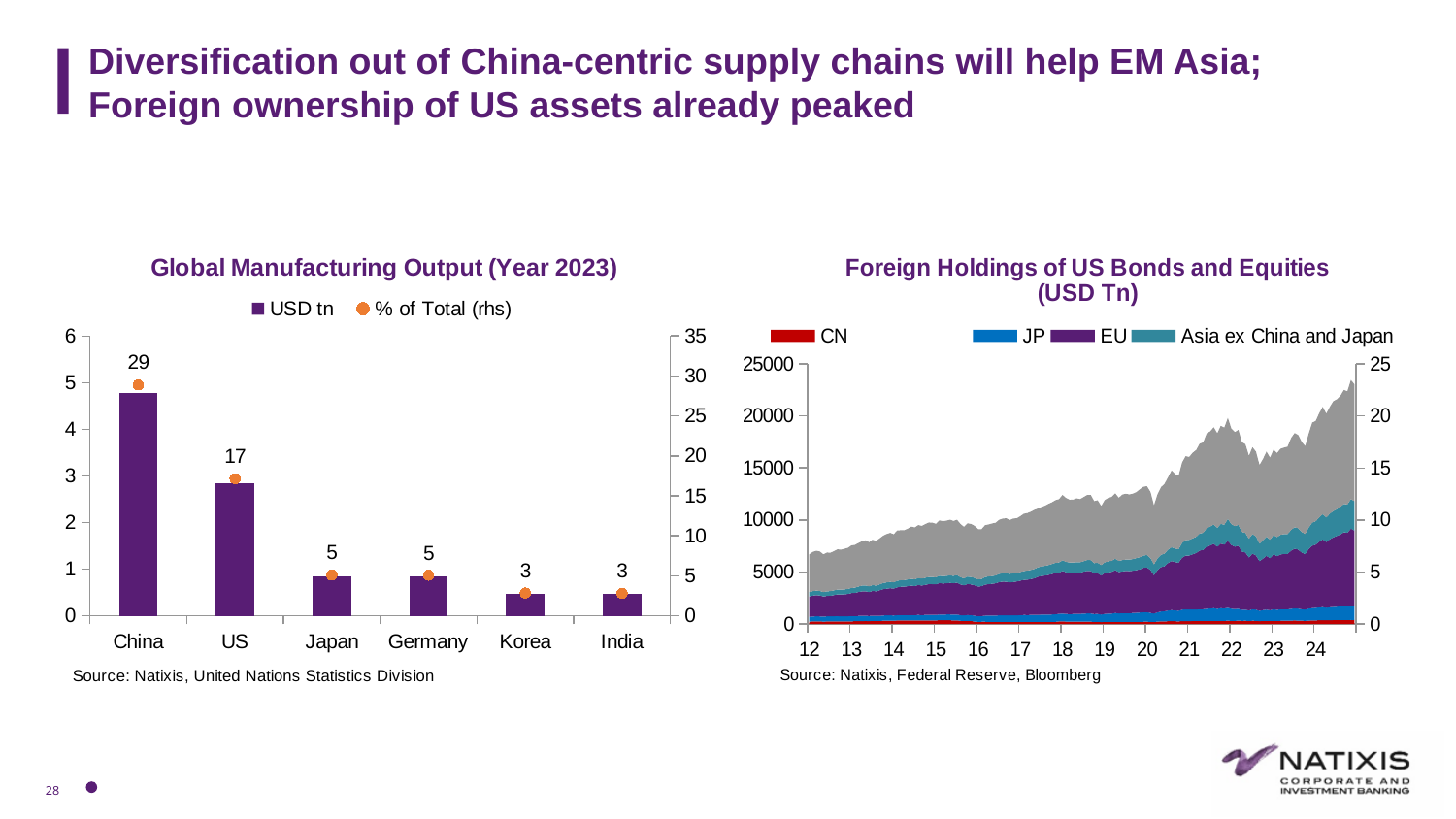
In the Global Manufacturing Output chart, is the USD tn value for China greater or less than 4? greater In the Global Manufacturing Output chart, is the USD tn value for the US greater or less than 2? greater How many series does the legend of the Global Manufacturing Output chart list? 2 In the Foreign Holdings of US Bonds and Equities chart, do total holdings generally rise or fall from 12 to 24? rise In the Global Manufacturing Output chart, what is the % of Total value for the US? 17 In the Global Manufacturing Output chart, what is the % of Total value for China? 29 In the Global Manufacturing Output chart, which has a larger % of Total, Japan or Korea? Japan In the Global Manufacturing Output chart, what is the difference in % of Total between China and the US? 12 How many countries are shown in the Global Manufacturing Output chart? 6 How many series does the legend of the Foreign Holdings of US Bonds and Equities chart list? 4 In the Global Manufacturing Output chart, which country has the highest % of Total? China What kind of chart is the Global Manufacturing Output chart? bar chart